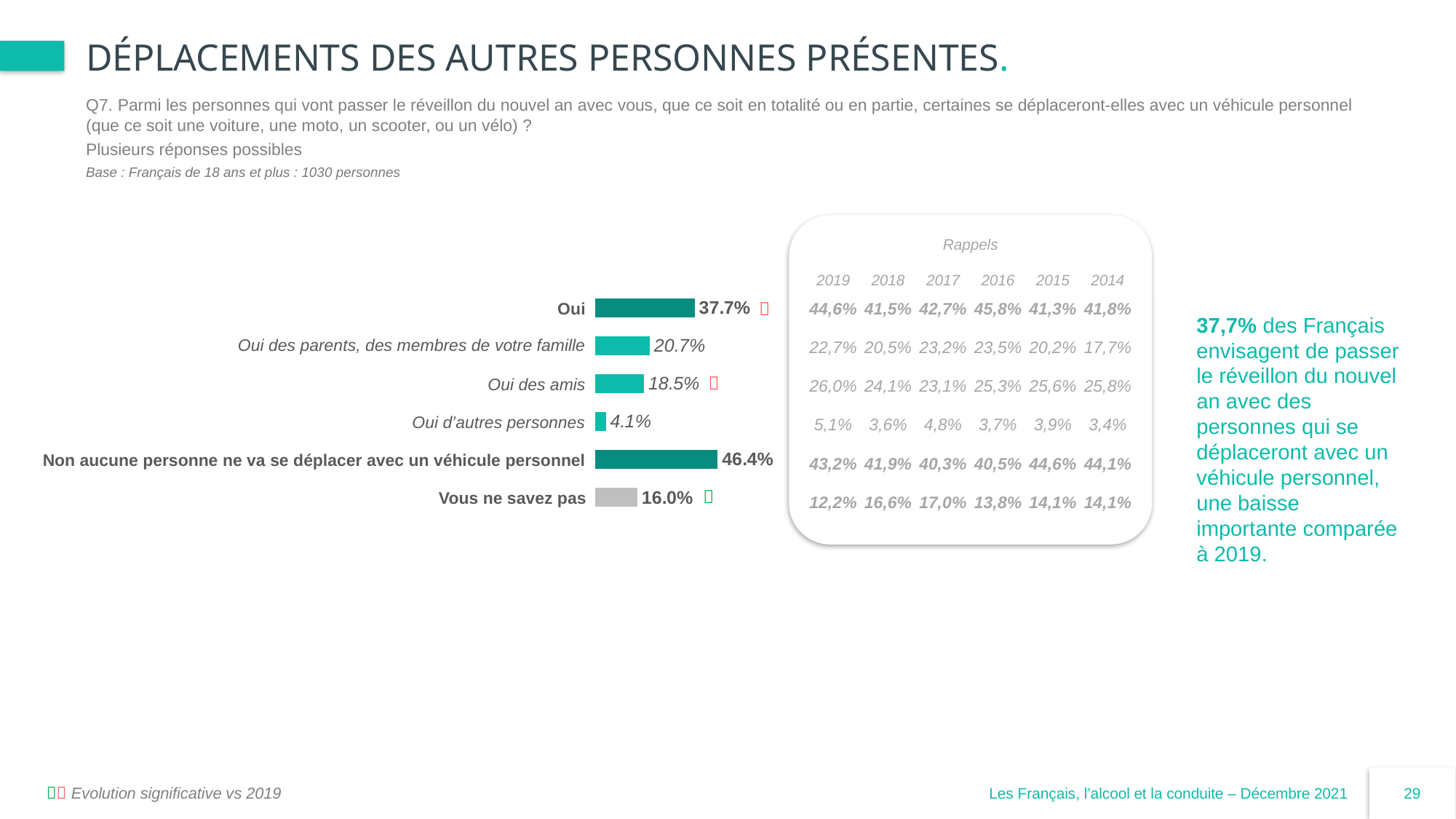
How many categories are shown in the bar chart? 6 What is the difference between the values for "Oui des parents, des membres de votre famille" and "Oui des amis"? 2.2% What is the value for "Vous ne savez pas"? 16.0% Which category has the lowest value in the bar chart? Oui d'autres personnes What is the value for "Oui des parents, des membres de votre famille"? 20.7% Which is larger: the value for "Oui des amis" or the value for "Vous ne savez pas"? Oui des amis What is the value for "Non aucune personne ne va se déplacer avec un véhicule personnel"? 46.4% What is the value for "Oui" in the bar chart? 37.7% What is the value for "Oui des amis"? 18.5% What kind of chart is shown on the slide? Bar chart Which category has the highest value in the bar chart? Non aucune personne ne va se déplacer avec un véhicule personnel What is the difference between the values for "Non aucune personne ne va se déplacer avec un véhicule personnel" and "Oui"? 8.7%